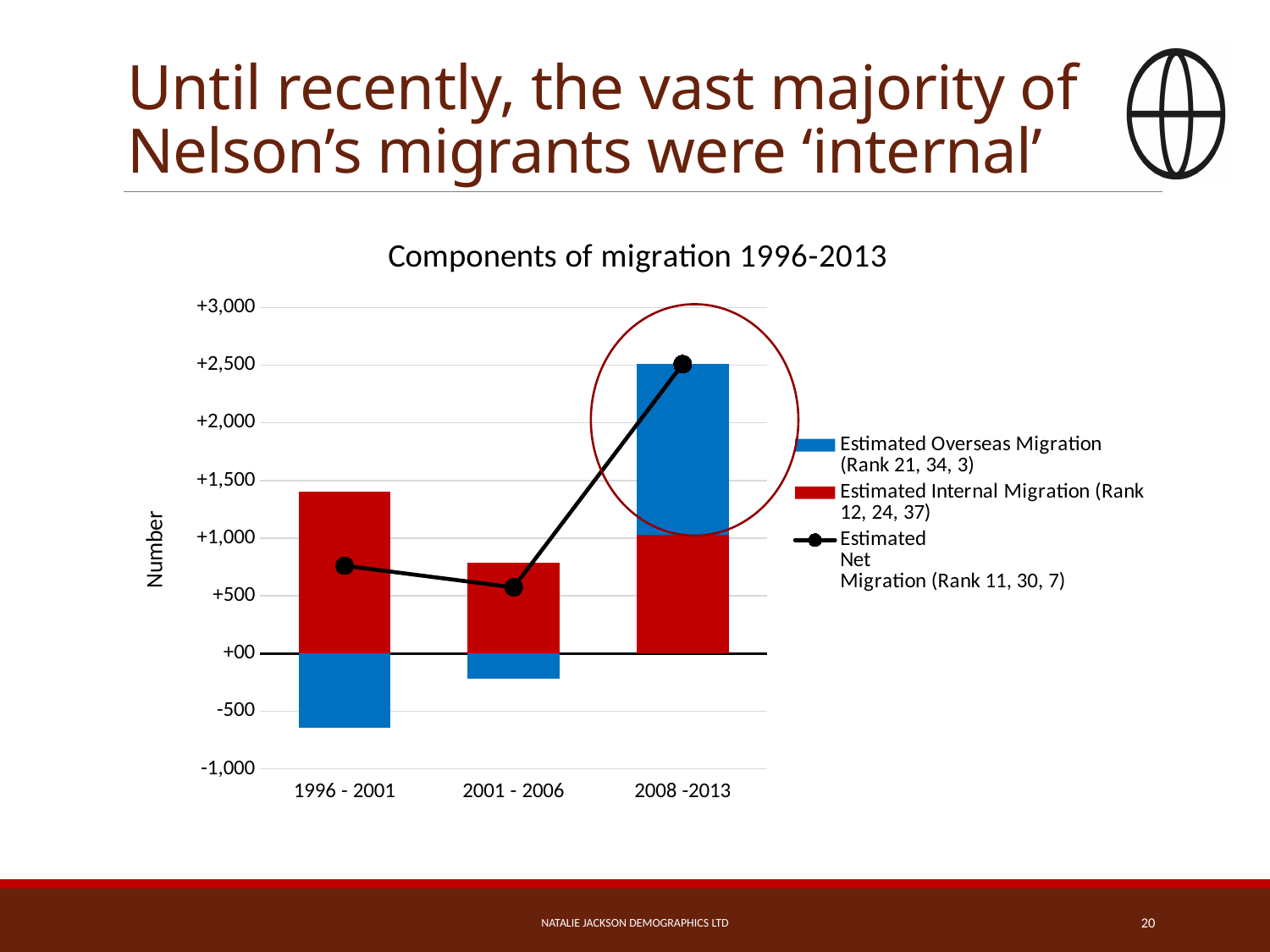
What kind of chart is shown on the slide? Bar chart with a line Which period has the highest Estimated Internal Migration? 1996 - 2001 Does the Estimated Net Migration rise or fall from 2001 - 2006 to 2008 -2013? rise Is the Estimated Net Migration for 2008 -2013 greater or less than +2,000? greater Which period has the highest Estimated Net Migration? 2008 -2013 Which period has the lowest Estimated Net Migration? 2001 - 2006 Is the Estimated Net Migration for 2001 - 2006 greater or less than +1,000? less How many time periods are shown on the x axis of the chart? 3 What is the label on the vertical axis of the chart? Number What is the title of the chart? Components of migration 1996-2013 How many series does the chart legend list? 3 Is the Estimated Internal Migration for 1996 - 2001 greater or less than +1,000? greater